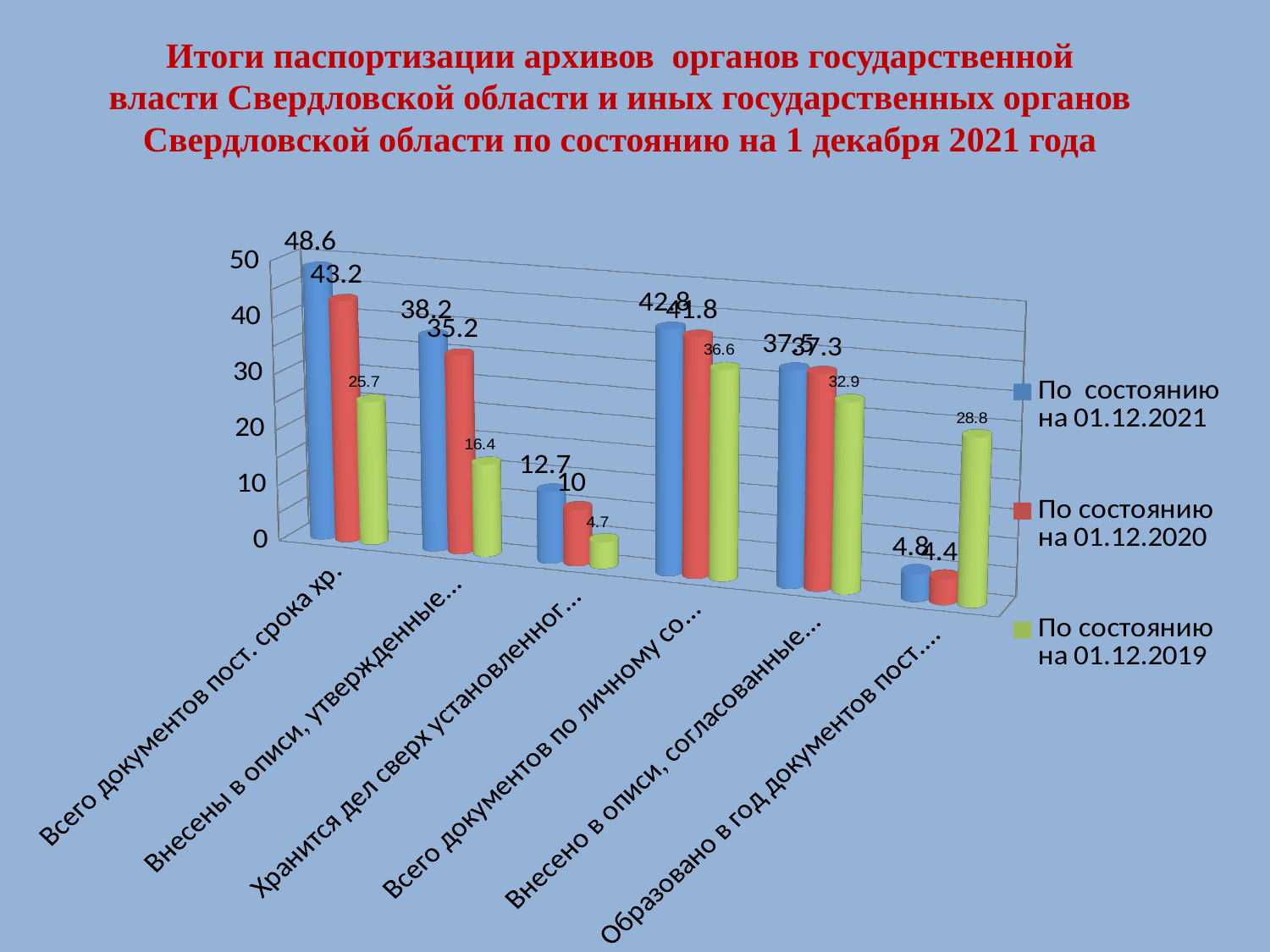
What is the value for the series 'По состоянию на 01.12.2021' for the category 'Всего документов пост. срока хр.'? 48.6 For the category 'Всего документов пост. срока хр.', what is the difference between the 2021 value and the 2020 value? 5.4 For the category 'Всего документов пост. срока хр.', which is larger: the value for 01.12.2021 or the value for 01.12.2019? 01.12.2021 Which category has the lowest value for the series 'По состоянию на 01.12.2019'? Хранится дел сверх установленног... Which category has the highest value for the series 'По состоянию на 01.12.2021'? Всего документов пост. срока хр. What is the value for the series 'По состоянию на 01.12.2019' for the category beginning 'Образовано в год документов пост....'? 28.8 What is the value for the series 'По состоянию на 01.12.2019' for the category 'Всего документов пост. срока хр.'? 25.7 How many series does the legend list? 3 What kind of chart is shown on the slide? Bar chart How many categories are shown on the x axis? 6 For the category beginning 'Внесены в описи, утвержденные...', what is the difference between the 2021 value and the 2020 value? 3 What is the value for the series 'По состоянию на 01.12.2020' for the category beginning 'Хранится дел сверх установленног...'? 10